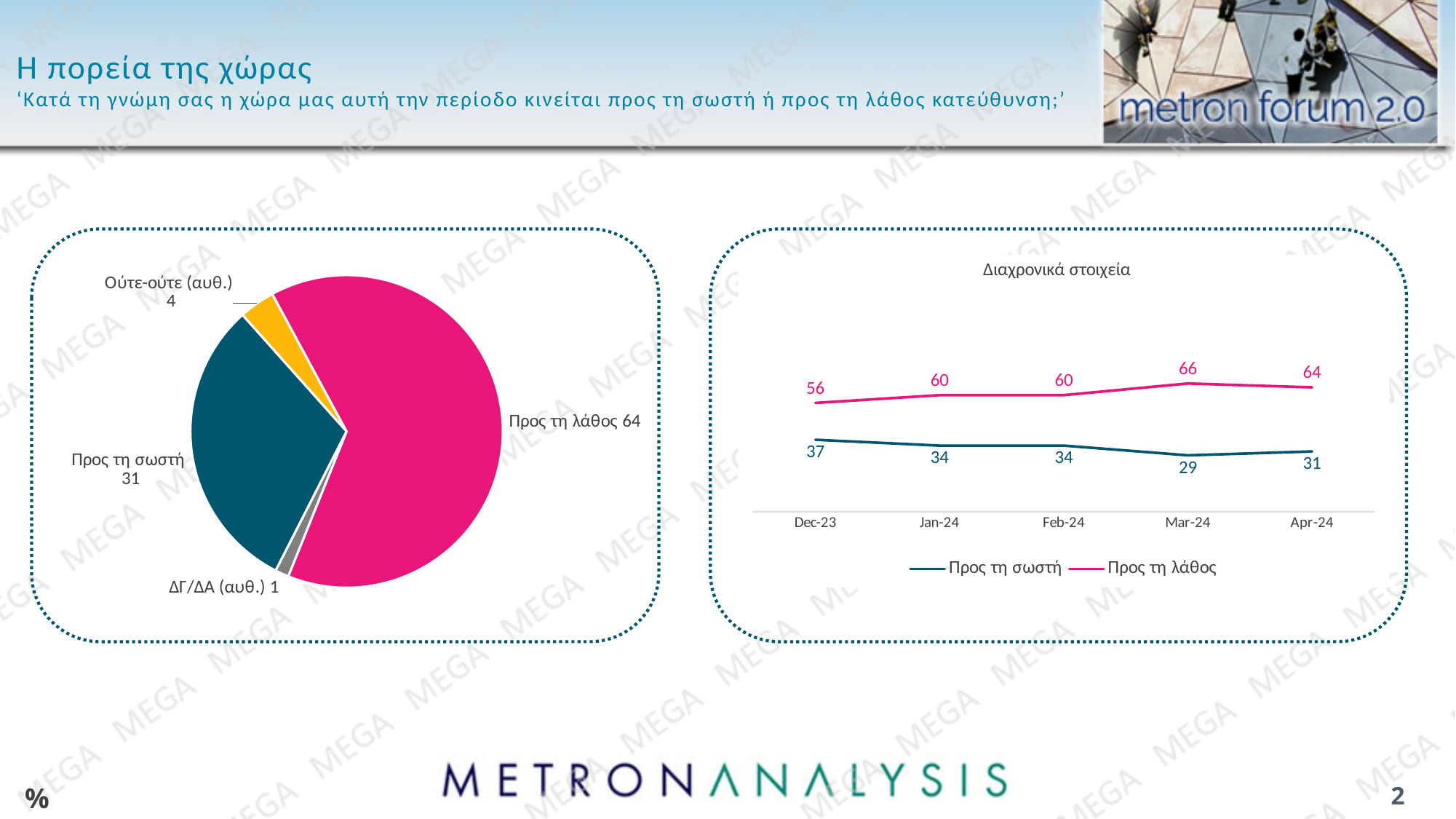
In the pie chart on the left, which category has the smallest slice? ΔΓ/ΔΑ (αυθ.) In the pie chart on the left, what is the value for 'Προς τη σωστή'? 31 What kind of chart is the chart on the left? Pie chart In the 'Διαχρονικά στοιχεία' chart, what is the value for 'Προς τη λάθος' in Mar-24? 66 In the 'Διαχρονικά στοιχεία' chart, in which month is 'Προς τη σωστή' lowest? Mar-24 In the pie chart on the left, what is the difference between 'Προς τη λάθος' and 'Προς τη σωστή'? 33 In the 'Διαχρονικά στοιχεία' chart, what is the difference between 'Προς τη λάθος' and 'Προς τη σωστή' in Apr-24? 33 In the 'Διαχρονικά στοιχεία' chart, what is the value for 'Προς τη σωστή' in Dec-23? 37 In the 'Διαχρονικά στοιχεία' chart, how many time points are shown on the x axis? 5 In the 'Διαχρονικά στοιχεία' chart, how many series does the legend list? 2 In the pie chart on the left, what is the value for 'Προς τη λάθος'? 64 In the pie chart on the left, how many slices are there? 4